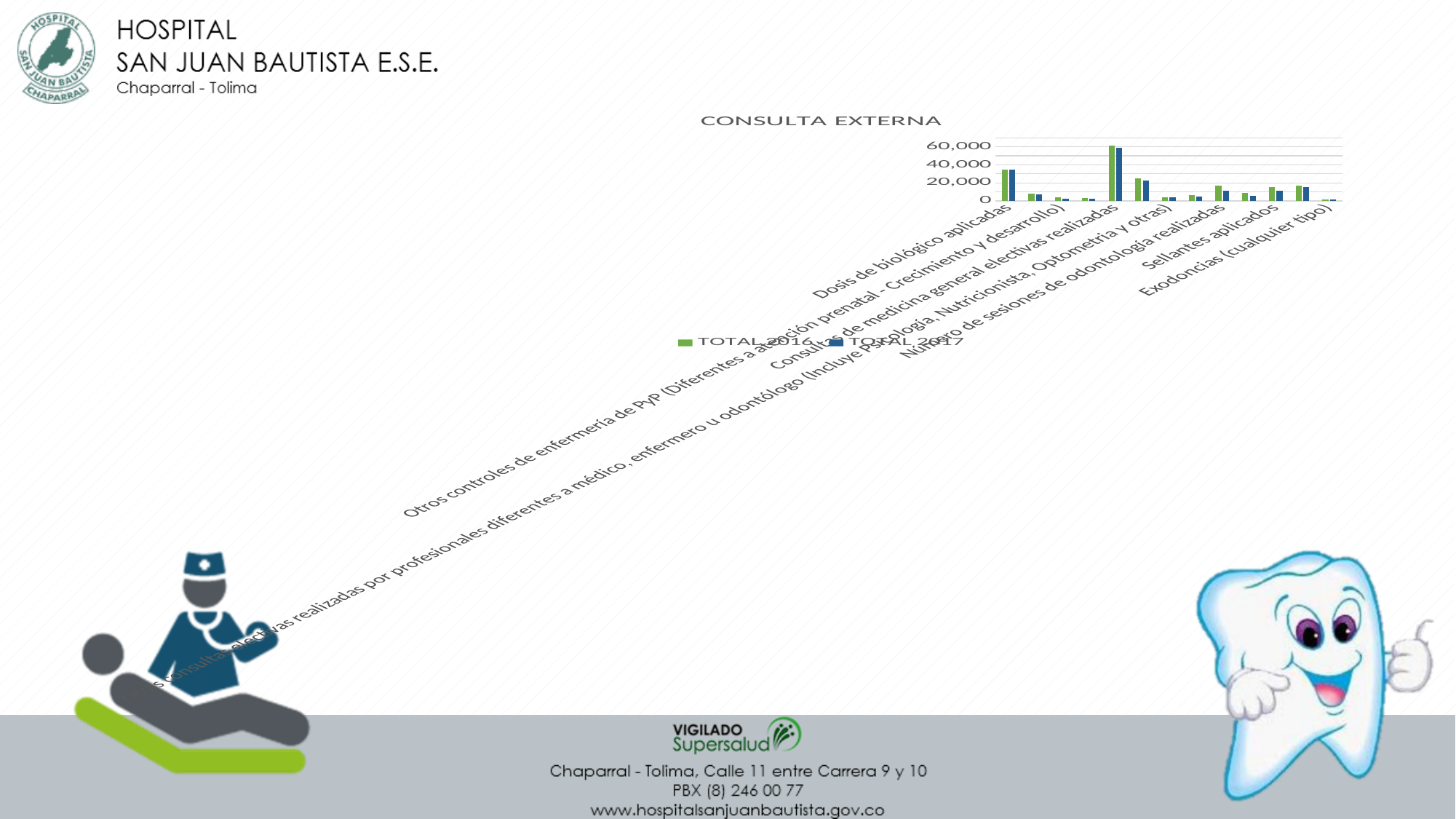
Is the TOTAL 2016 value for Dosis de biológico aplicadas greater or less than 20,000? greater What kind of chart is shown under the title CONSULTA EXTERNA? Bar chart For TOTAL 2016, which is larger: Dosis de biológico aplicadas or Sellantes aplicados? Dosis de biológico aplicadas Is the TOTAL 2017 value for Sellantes aplicados greater or less than 40,000? less How many series does the legend of the CONSULTA EXTERNA chart list? 2 What are the two legend entries in the CONSULTA EXTERNA chart? TOTAL 2016 and TOTAL 2017 What is the title of the chart on the slide? CONSULTA EXTERNA For TOTAL 2017, which is larger: Consultas de medicina general electivas realizadas or Dosis de biológico aplicadas? Consultas de medicina general electivas realizadas Is the TOTAL 2016 value for Consultas de medicina general electivas realizadas greater or less than 40,000? greater Which category has the highest bars in the CONSULTA EXTERNA chart? Consultas de medicina general electivas realizadas